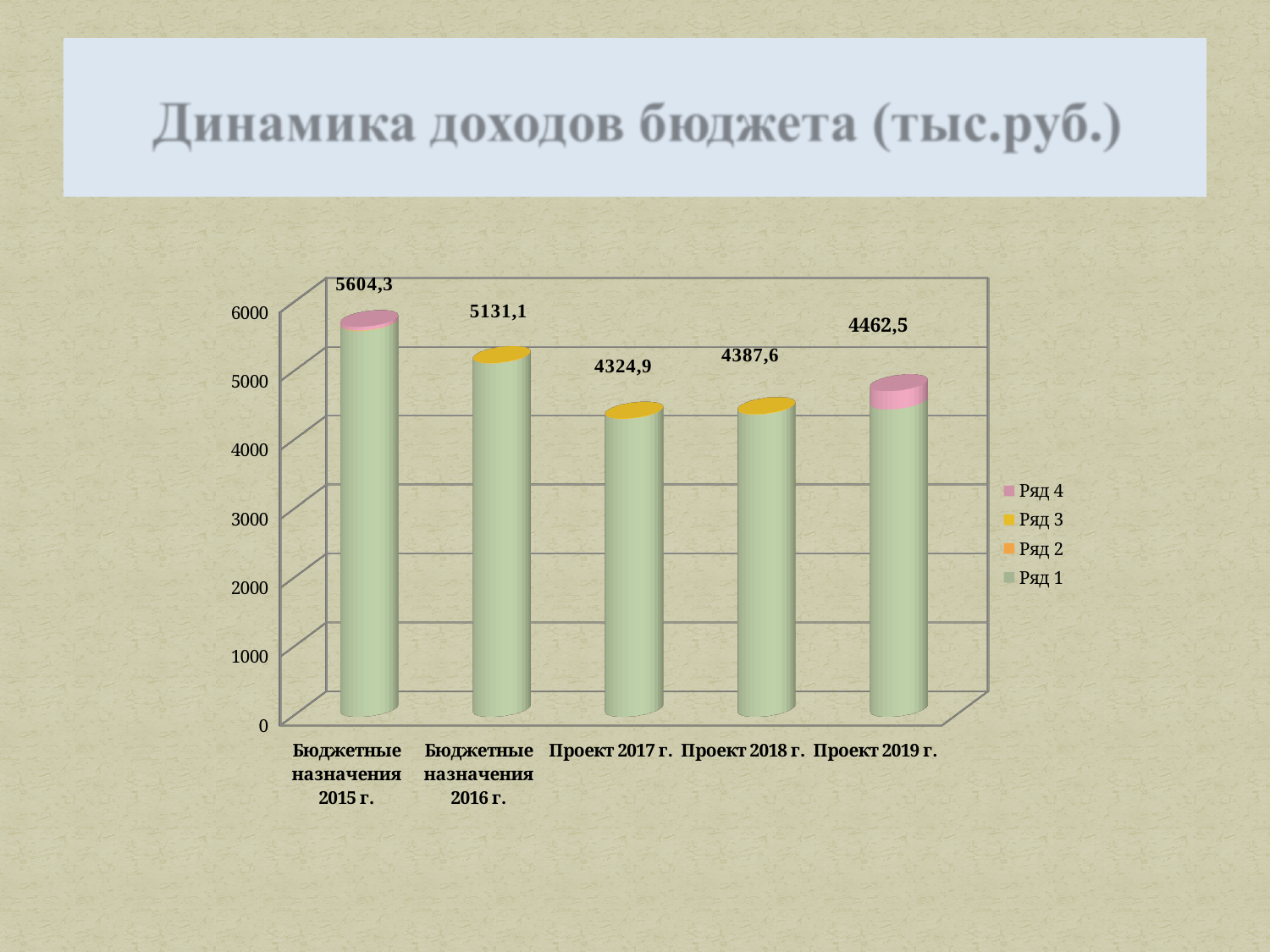
How many series does the legend list? 4 What is the difference between the values for Бюджетные назначения 2015 г. and Бюджетные назначения 2016 г.? 473,2 What is the title of the chart? Динамика доходов бюджета (тыс.руб.) Which is larger, the value for Проект 2017 г. or the value for Проект 2019 г.? Проект 2019 г. How many categories are shown on the x axis? 5 What is the value for Бюджетные назначения 2015 г.? 5604,3 What is the value for Проект 2018 г.? 4387,6 Is the value for Бюджетные назначения 2016 г. greater or less than 5000? greater Which category has the highest value? Бюджетные назначения 2015 г. What is the value for Проект 2019 г.? 4462,5 Which category has the lowest value? Проект 2017 г. What is the difference between the values for Проект 2019 г. and Проект 2018 г.? 74,9